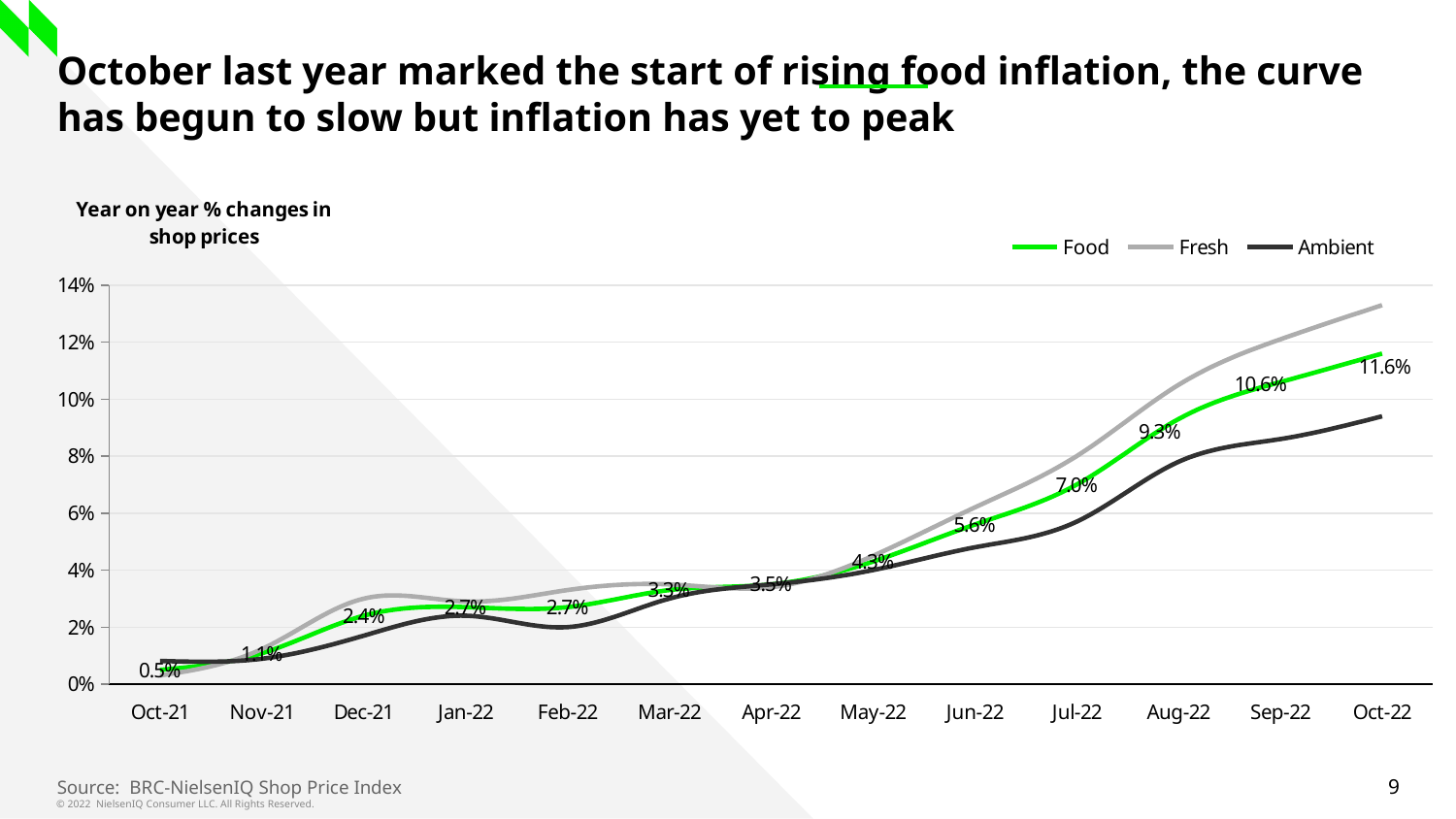
How many series does the legend list? 3 What is the difference between the Food values for Oct-22 and Sep-22? 1.0% How many months are shown on the x axis? 13 Which is larger, the Food value for Jun-22 or for May-22? Jun-22 In which month is the Food series at its lowest value? Oct-21 Is the Fresh value for Oct-22 greater or less than 12%? greater Is the Ambient value for Oct-22 greater or less than 10%? less What is the Food value for Jul-22? 7.0% What is the Food value for Oct-22? 11.6% What is the Food value for Oct-21? 0.5% In which month does the Food series reach its highest value? Oct-22 What kind of chart is shown on the slide? Line chart